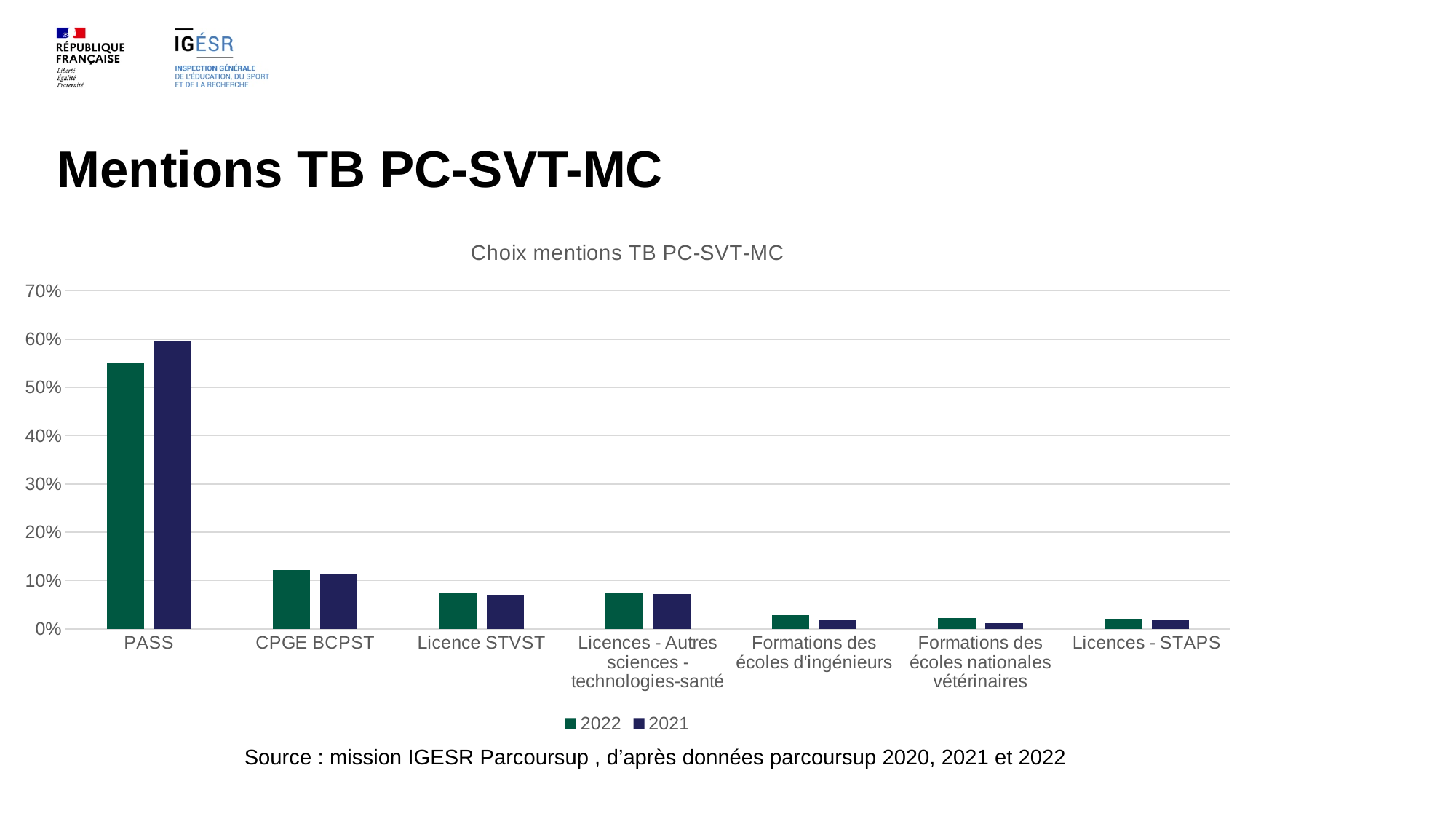
What kind of chart is shown on the slide? bar chart How many series does the chart legend list? 2 Is the 2022 value for CPGE BCPST greater or less than 10%? greater Is the 2022 value for PASS greater or less than 60%? less Which category has the highest value for the 2021 series? PASS For CPGE BCPST, which series has the larger value, 2022 or 2021? 2022 What is the title of the chart? Choix mentions TB PC-SVT-MC Which category has the highest value for the 2022 series? PASS Is the 2021 value for PASS greater or less than 50%? greater For PASS, which series has the larger value, 2022 or 2021? 2021 How many categories are shown on the x axis of the chart? 7